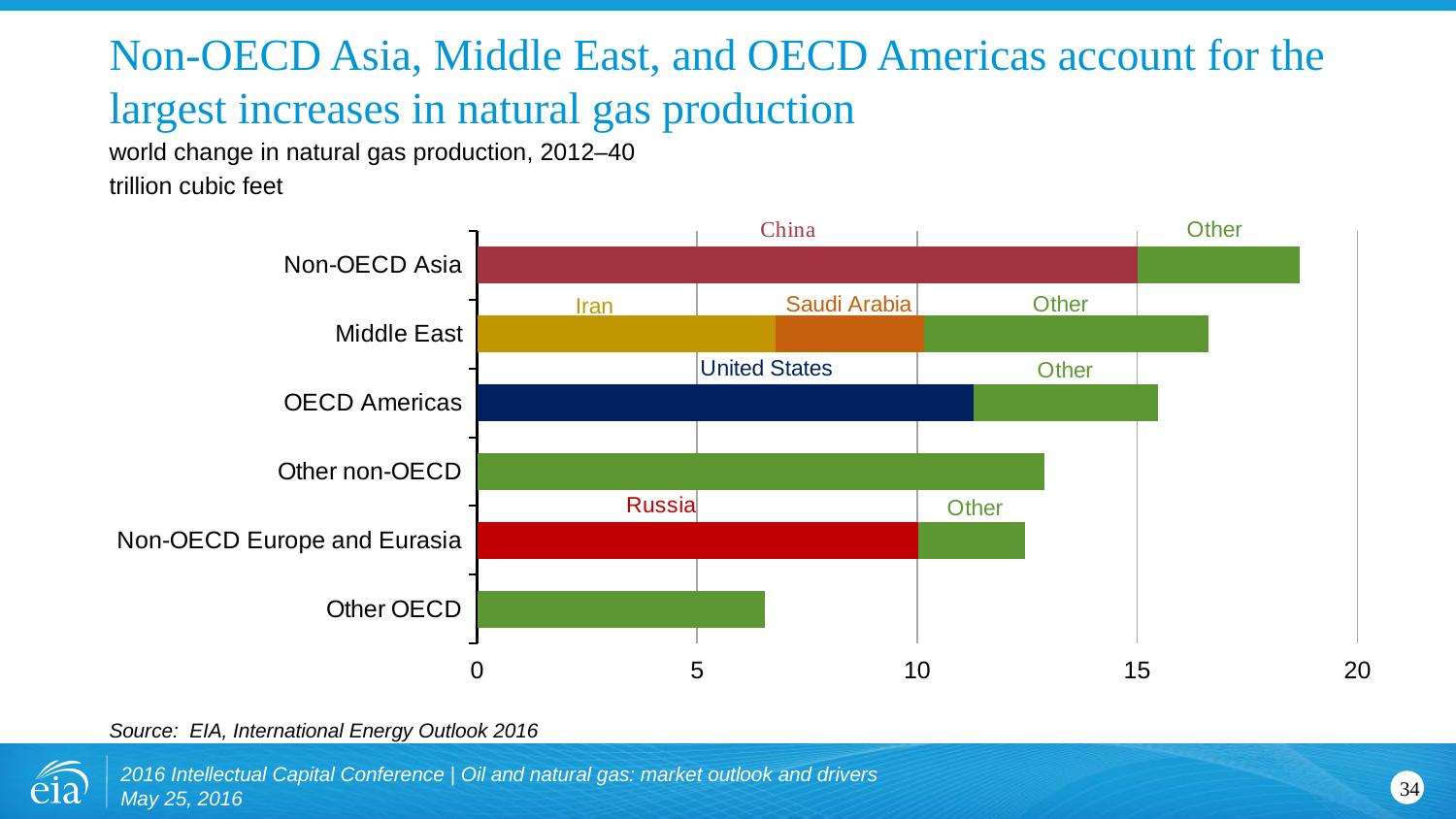
Is the United States segment of the OECD Americas bar greater or less than 10? greater How many regions are plotted on the chart? 6 Which is larger, the bar for OECD Americas or the bar for Other OECD? OECD Americas Is the value for Other OECD greater or less than 10? less Is the total value for Non-OECD Asia greater or less than 15? greater What kind of chart is shown on the slide? bar chart Which is larger, the bar for Non-OECD Asia or the bar for Middle East? Non-OECD Asia Which region has the smallest change in natural gas production? Other OECD What unit is the chart measured in, according to the subtitle? trillion cubic feet Which region has the largest change in natural gas production? Non-OECD Asia Do the bar lengths decrease from the top of the chart to the bottom? yes